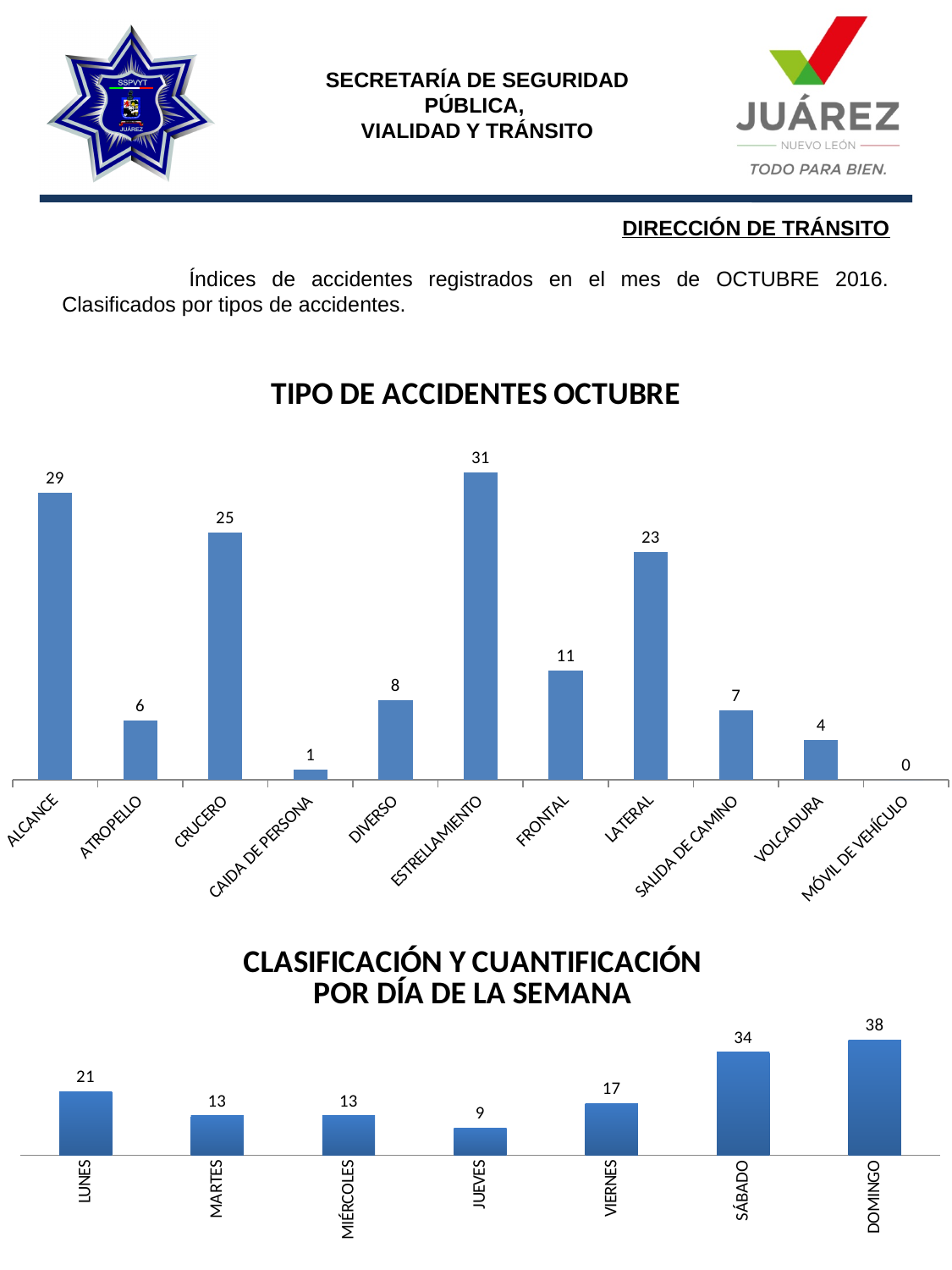
In the 'CLASIFICACIÓN Y CUANTIFICACIÓN POR DÍA DE LA SEMANA' chart, what is the value for DOMINGO? 38 In the 'CLASIFICACIÓN Y CUANTIFICACIÓN POR DÍA DE LA SEMANA' chart, which is larger, LUNES or MARTES? LUNES In the 'TIPO DE ACCIDENTES OCTUBRE' chart, what is the value for ESTRELLAMIENTO? 31 In the 'TIPO DE ACCIDENTES OCTUBRE' chart, which is larger, FRONTAL or LATERAL? LATERAL In the 'CLASIFICACIÓN Y CUANTIFICACIÓN POR DÍA DE LA SEMANA' chart, which day has the lowest value? JUEVES In the 'TIPO DE ACCIDENTES OCTUBRE' chart, which category has the lowest value? MÓVIL DE VEHÍCULO In the 'TIPO DE ACCIDENTES OCTUBRE' chart, what is the difference between ALCANCE and CRUCERO? 4 In the 'TIPO DE ACCIDENTES OCTUBRE' chart, which category has the highest value? ESTRELLAMIENTO In the 'CLASIFICACIÓN Y CUANTIFICACIÓN POR DÍA DE LA SEMANA' chart, what is the difference between SÁBADO and VIERNES? 17 How many categories are shown in the 'TIPO DE ACCIDENTES OCTUBRE' chart? 11 What kind of chart is 'TIPO DE ACCIDENTES OCTUBRE'? Bar chart How many days are shown in the 'CLASIFICACIÓN Y CUANTIFICACIÓN POR DÍA DE LA SEMANA' chart? 7